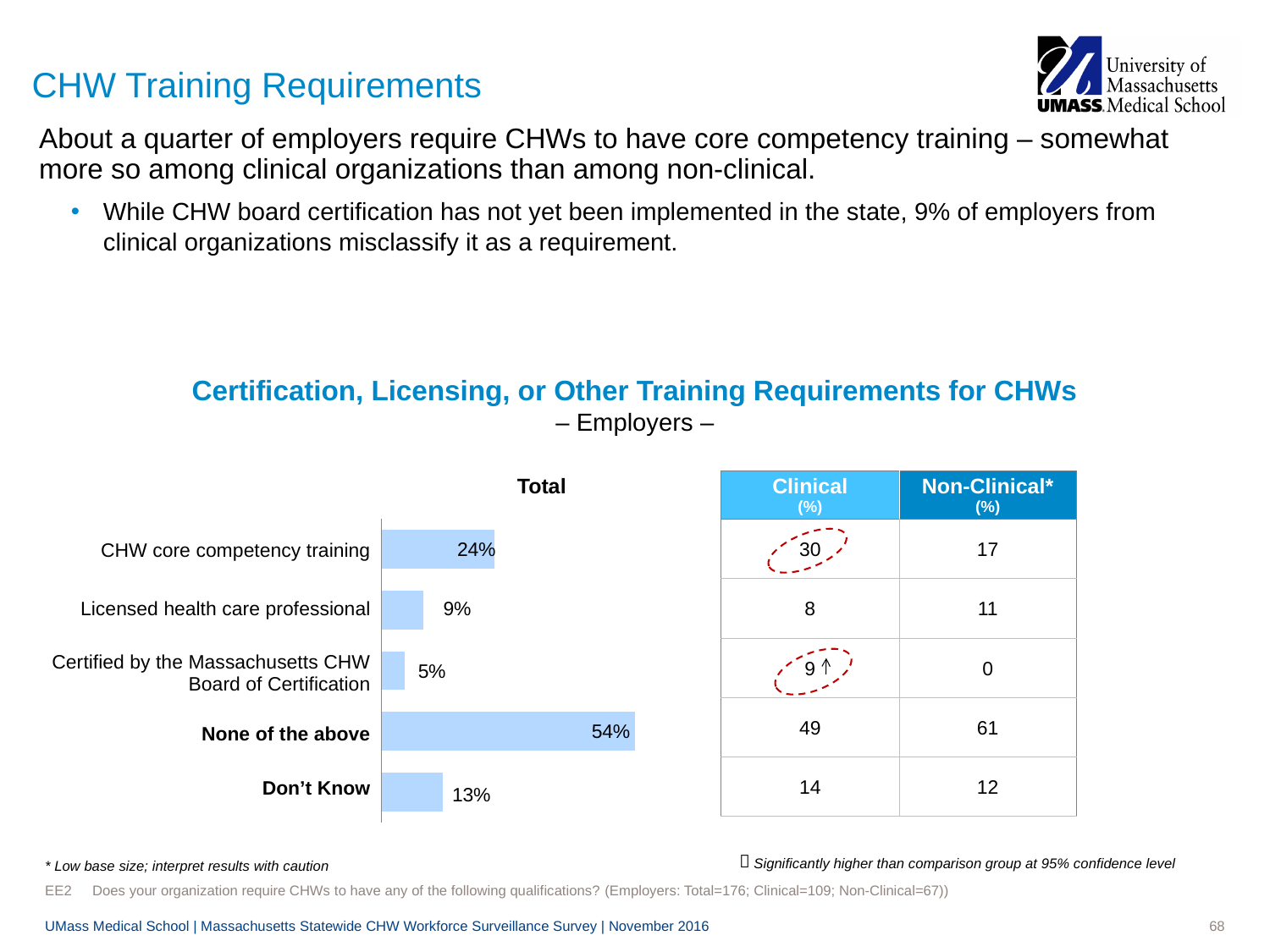
What is the Clinical percentage for CHW core competency training in the table? 30 How many categories are shown in the bar chart? 5 What is the Non-Clinical percentage for Certified by the Massachusetts CHW Board of Certification in the table? 0 Which category has the lowest Total value? Certified by the Massachusetts CHW Board of Certification What is the Total value for None of the above? 54% Which category has the highest Total value? None of the above What kind of chart is used to show the Total values? Bar chart What is the Total value for CHW core competency training? 24% What is the difference between the Total values for None of the above and CHW core competency training? 30% Which has a larger Total value: Licensed health care professional or Don't Know? Don't Know What is the Total value for Don't Know? 13% What is the title of the chart? Certification, Licensing, or Other Training Requirements for CHWs